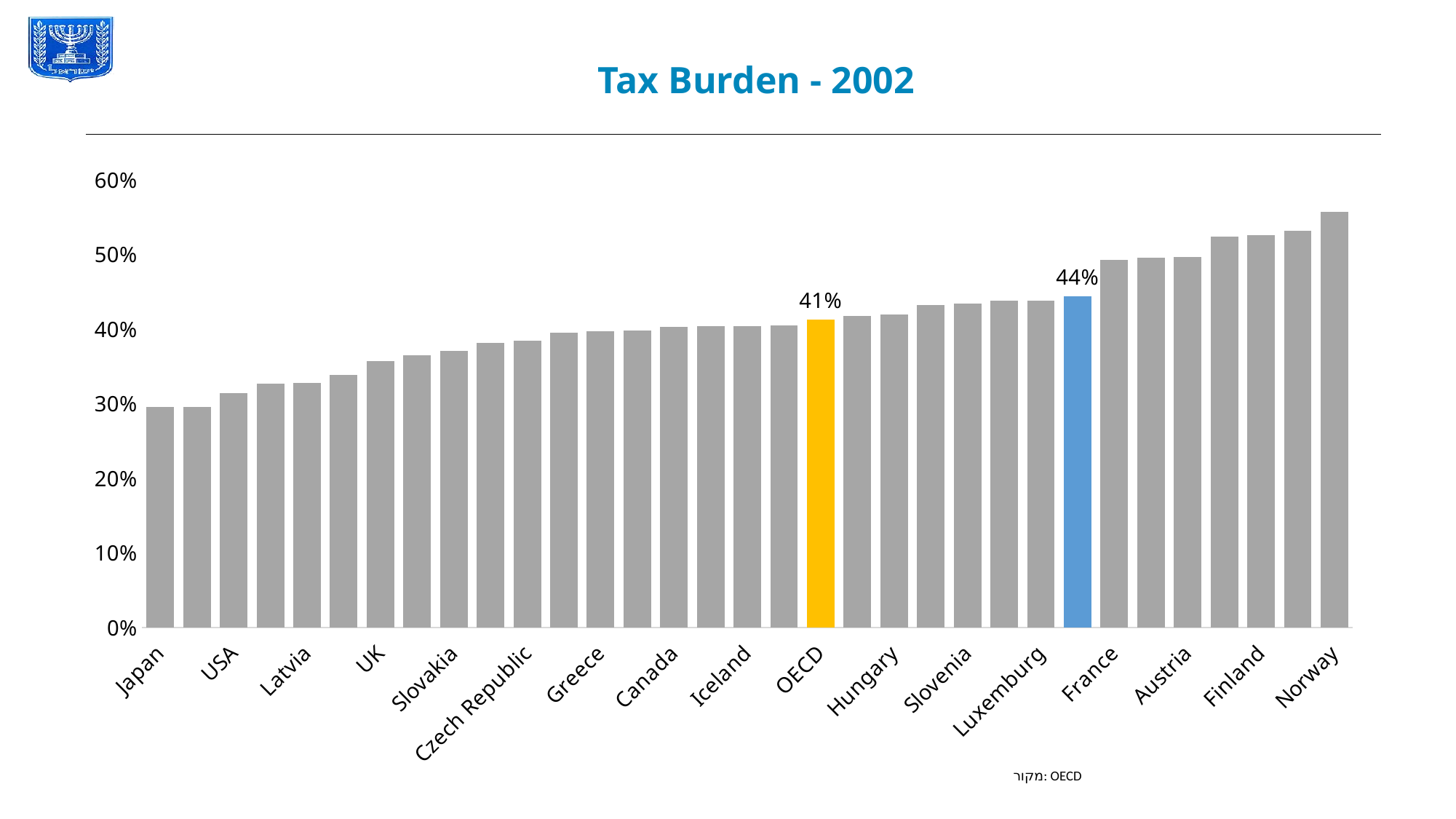
Which is larger, the value for France or the value for OECD? France Which labelled country has the highest tax burden? Norway What type of chart is shown on the slide? bar chart Is the value for Norway greater or less than 50%? greater Is the value for Hungary greater or less than 40%? greater What is the title of the chart? Tax Burden - 2002 What is the tax burden value shown for OECD? 41% Which is larger, the value for UK or the value for Finland? Finland Do the values rise or fall moving from left to right along the x axis? rise Is the value for UK greater or less than 40%? less